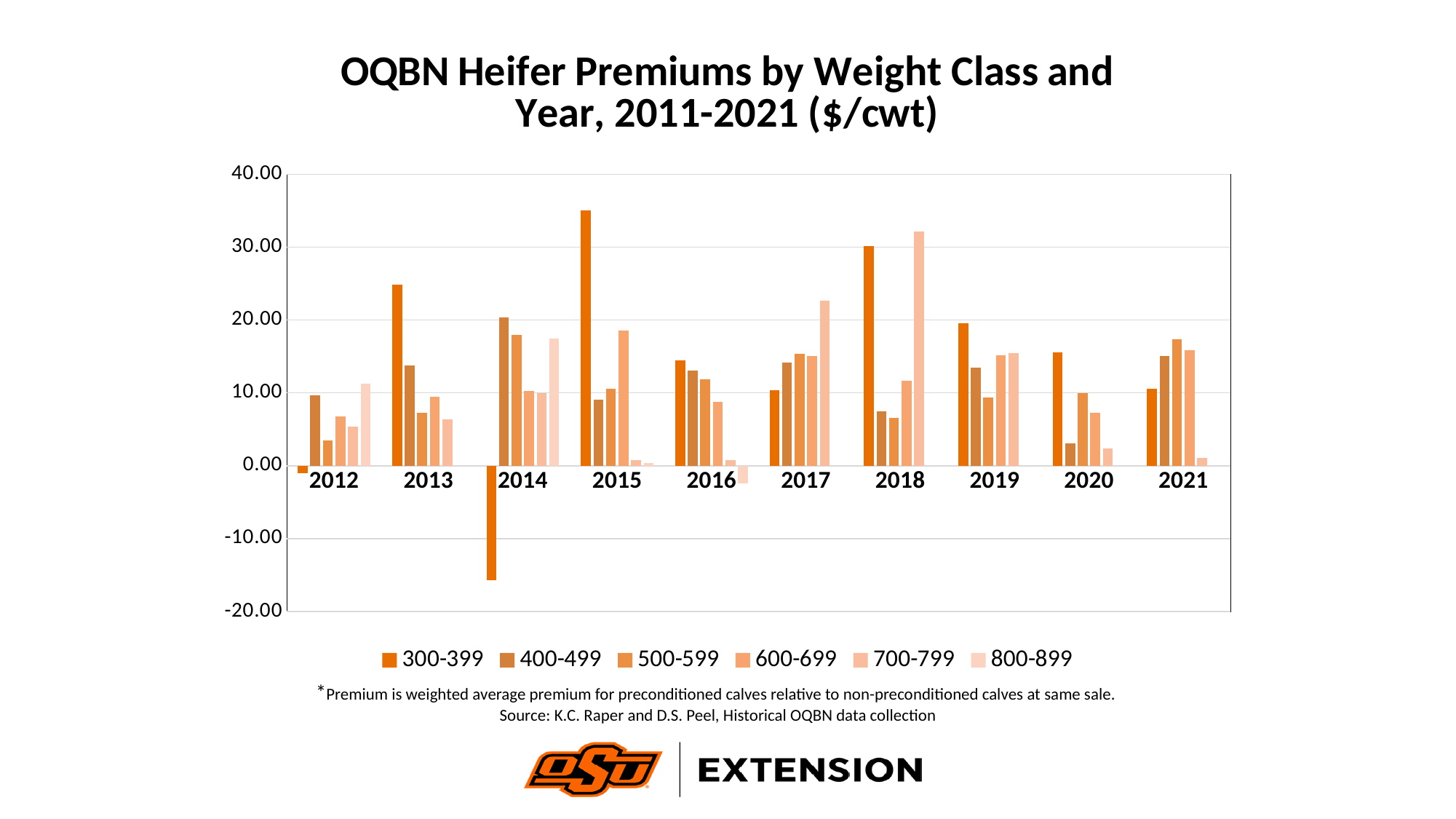
In 2020, which is larger: the premium for 300-399 or for 400-499? 300-399 How many series does the legend list? 6 Is the value for the 400-499 weight class in 2020 greater or less than 10.00? less Is the value for the 300-399 weight class in 2014 greater or less than -10.00? less Is the value for the 300-399 weight class in 2015 greater or less than 30.00? greater How many years are shown along the x axis? 10 In 2013, which is larger: the premium for 300-399 or for 400-499? 300-399 In which year is the 300-399 weight class premium lowest? 2014 In which year is the 300-399 weight class premium highest? 2015 What is the title of the chart? OQBN Heifer Premiums by Weight Class and Year, 2011-2021 ($/cwt) What kind of chart is shown on the slide? bar chart